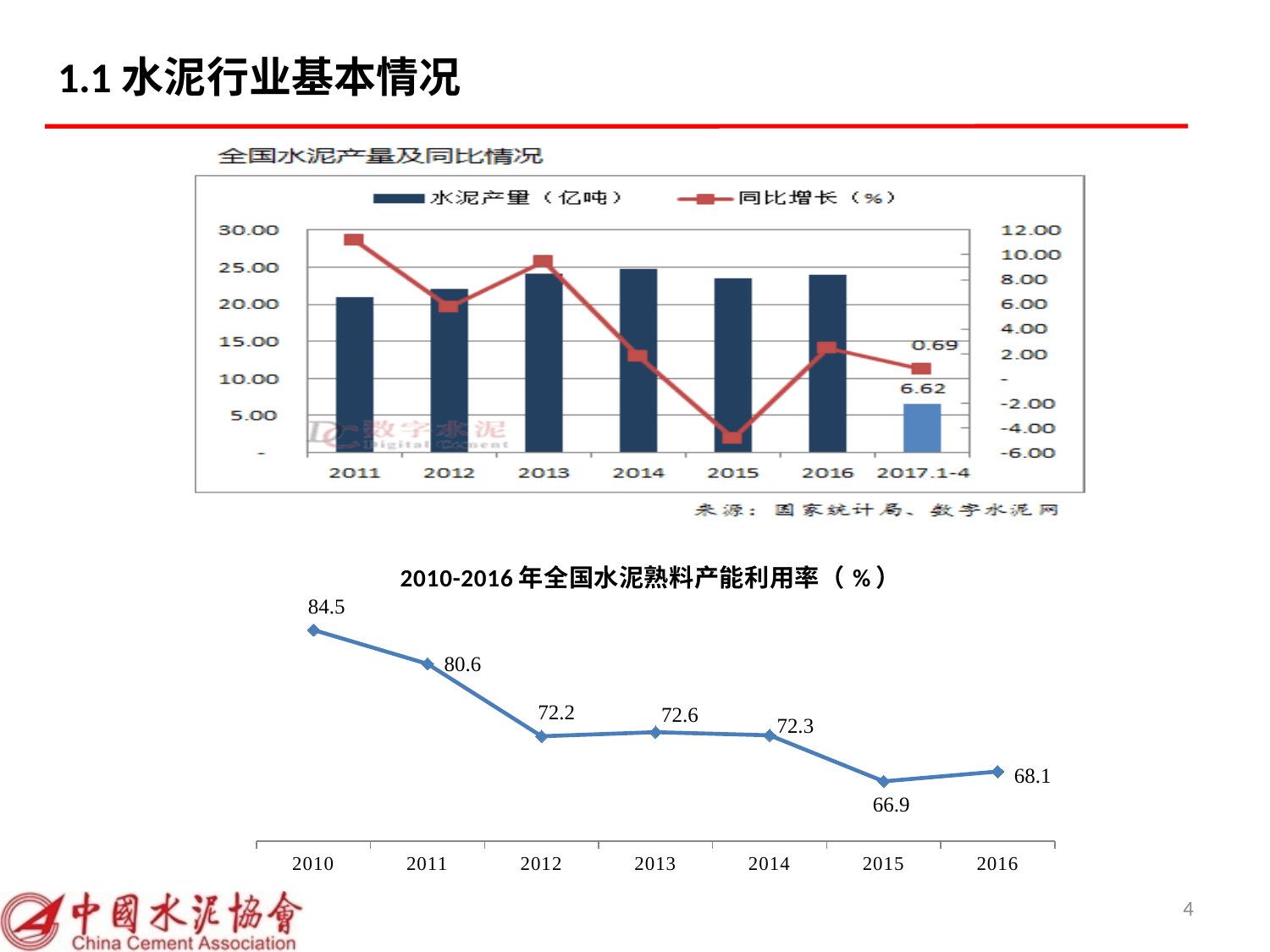
In the top chart (全国水泥产量及同比情况), what is the cement output (水泥产量) labelled for 2017.1-4? 6.62 In the bottom chart (2010-2016年全国水泥熟料产能利用率), which year has the lowest value? 2015 In the top chart (全国水泥产量及同比情况), which category has the shortest 水泥产量 bar? 2017.1-4 In the bottom chart (2010-2016年全国水泥熟料产能利用率), do the values generally rise or fall from 2010 to 2016? fall In the top chart (全国水泥产量及同比情况), in which year does the 同比增长 line reach its lowest point? 2015 In the top chart (全国水泥产量及同比情况), is the 水泥产量 bar for 2014 greater or less than 20.00? greater In the bottom chart (2010-2016年全国水泥熟料产能利用率), which is larger, the value for 2012 or for 2013? 2013 In the top chart (全国水泥产量及同比情况), what is the year-on-year growth (同比增长) labelled for 2017.1-4? 0.69 In the top chart (全国水泥产量及同比情况), how many series does the legend list? 2 In the bottom chart (2010-2016年全国水泥熟料产能利用率), what is the value for 2010? 84.5 In the bottom chart (2010-2016年全国水泥熟料产能利用率), what is the difference between the 2010 and 2011 values? 3.9 In the top chart (全国水泥产量及同比情况), is the 同比增长 value for 2015 greater or less than -2.00? less